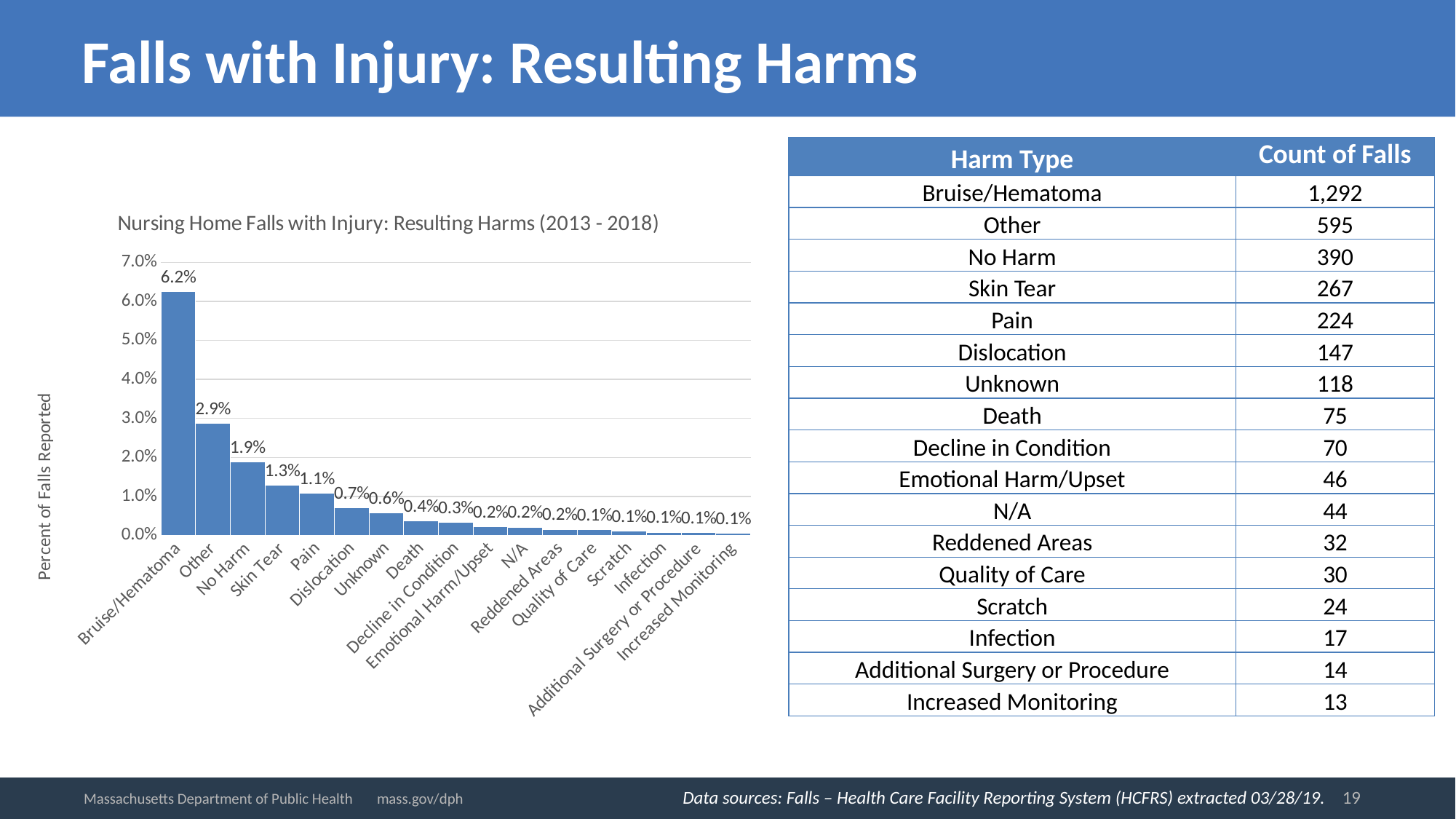
Which category has the highest value in the chart? Bruise/Hematoma Which is larger in the chart, the value for Other or the value for No Harm? Other What is the value for No Harm in the chart? 1.9% Is the value for Bruise/Hematoma greater or less than 5.0%? greater How many categories are shown on the x axis of the chart? 17 What is the title of the chart? Nursing Home Falls with Injury: Resulting Harms (2013 - 2018) What is the value for Dislocation in the chart? 0.7% What is the value for Death in the chart? 0.4% What kind of chart is shown on the slide? bar chart What is the difference between the values for Skin Tear and Pain in the chart? 0.2% What is the difference between the values for Bruise/Hematoma and Other in the chart? 3.3% What is the value for Bruise/Hematoma in the chart? 6.2%